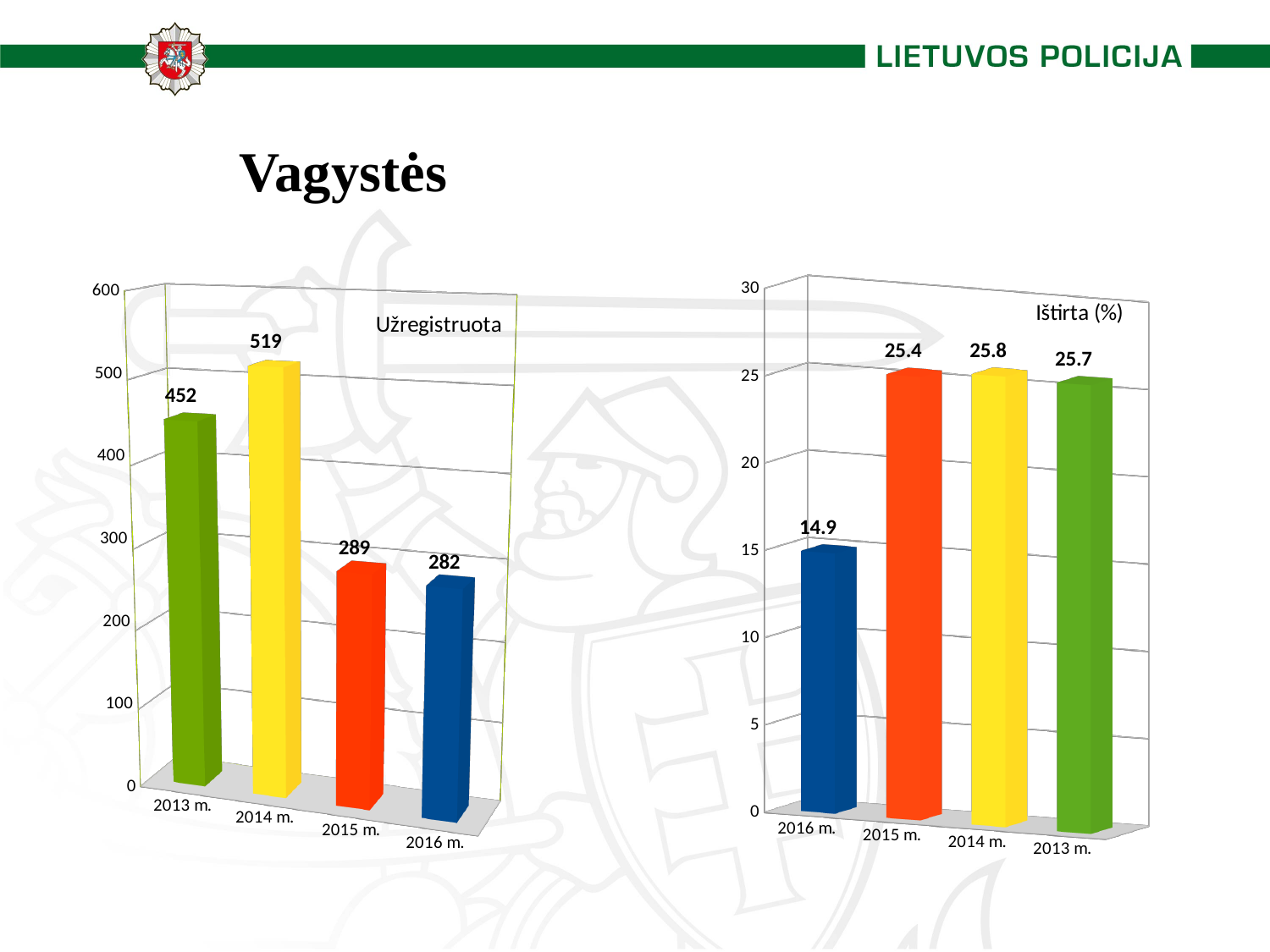
In the Užregistruota chart, how many years are shown? 4 In the Ištirta (%) chart, what is the value for 2014 m.? 25.8 In the Ištirta (%) chart, which is larger, the value for 2015 m. or 2016 m.? 2015 m. In the Ištirta (%) chart, which year has the lowest value? 2016 m. In the Užregistruota chart, which year has the highest value? 2014 m. In the Ištirta (%) chart, what is the value for 2016 m.? 14.9 In the Užregistruota chart, what is the value for 2014 m.? 519 In the Užregistruota chart, what is the value for 2016 m.? 282 In the Užregistruota chart, what is the difference between the values for 2014 m. and 2013 m.? 67 In the Užregistruota chart, which year has the lowest value? 2016 m. What type of chart is the Užregistruota chart? Bar chart In the Ištirta (%) chart, what is the difference between the values for 2015 m. and 2016 m.? 10.5